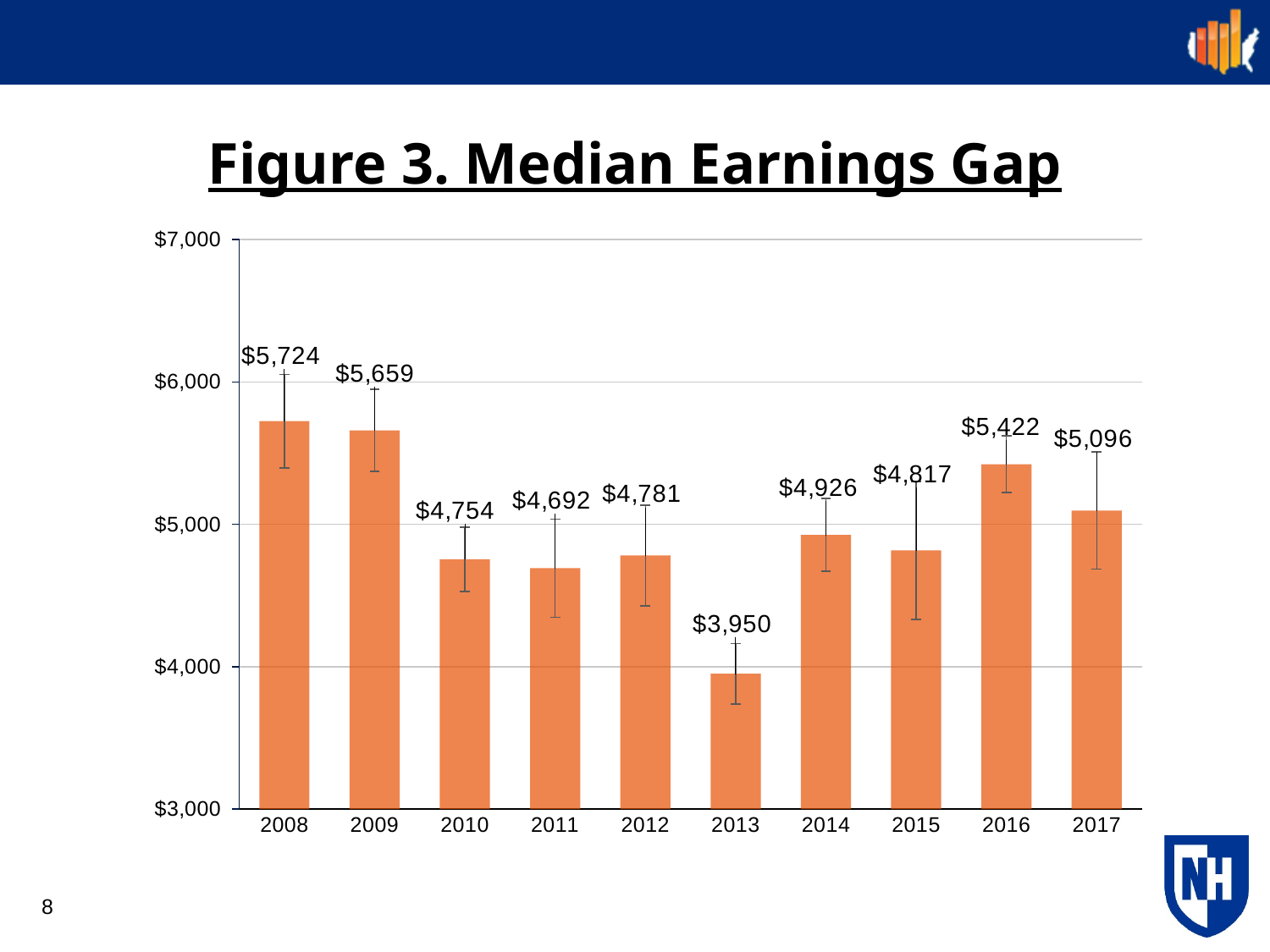
What kind of chart is shown on the slide? bar chart How many years are shown on the x axis? 10 What is the difference between the median earnings gap in 2008 and in 2009? $65 Which year has the lowest median earnings gap? 2013 What is the median earnings gap for 2016? $5,422 Which year has the highest median earnings gap? 2008 What is the median earnings gap for 2011? $4,692 Which year has a larger median earnings gap, 2014 or 2015? 2014 What is the title of the chart? Figure 3. Median Earnings Gap What is the median earnings gap for 2013? $3,950 What is the difference between the median earnings gap in 2016 and in 2017? $326 Is the value for 2013 greater or less than $4,000? less